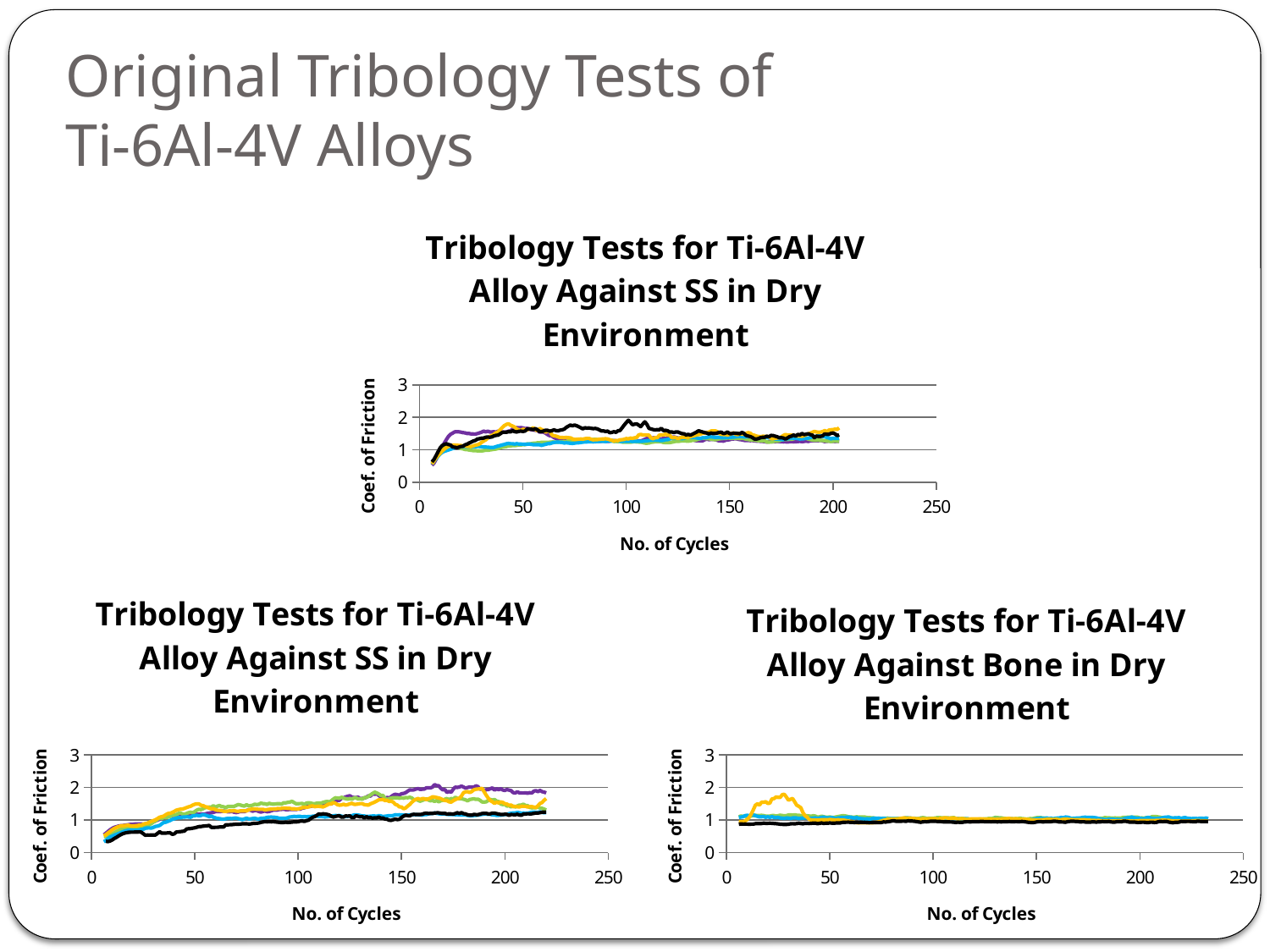
In the bottom-right chart (Against Bone), is the value of the black line at 200 cycles greater or less than 2? less In the top chart (Against SS), what is the title of the horizontal axis? No. of Cycles In the bottom-right chart (Against Bone), at around 25 cycles, which line has the larger value: the orange line or the black line? orange line In the bottom-right chart (Against Bone), is the peak value of the orange line greater or less than 2? less In the bottom-left chart (Against SS), at 200 cycles, which line has the larger value: the purple line or the black line? purple line What kind of chart is the bottom-right chart titled "Tribology Tests for Ti-6Al-4V Alloy Against Bone in Dry Environment"? Line chart In the bottom-left chart (Against SS), is the value of the purple line at 200 cycles greater or less than 1.5? greater In the bottom-right chart (Against Bone), what is the title of the vertical axis? Coef. of Friction What kind of chart is the top chart titled "Tribology Tests for Ti-6Al-4V Alloy Against SS in Dry Environment"? Line chart In the bottom-left chart (Against SS), do the coefficient of friction values generally rise or fall as the number of cycles increases? rise